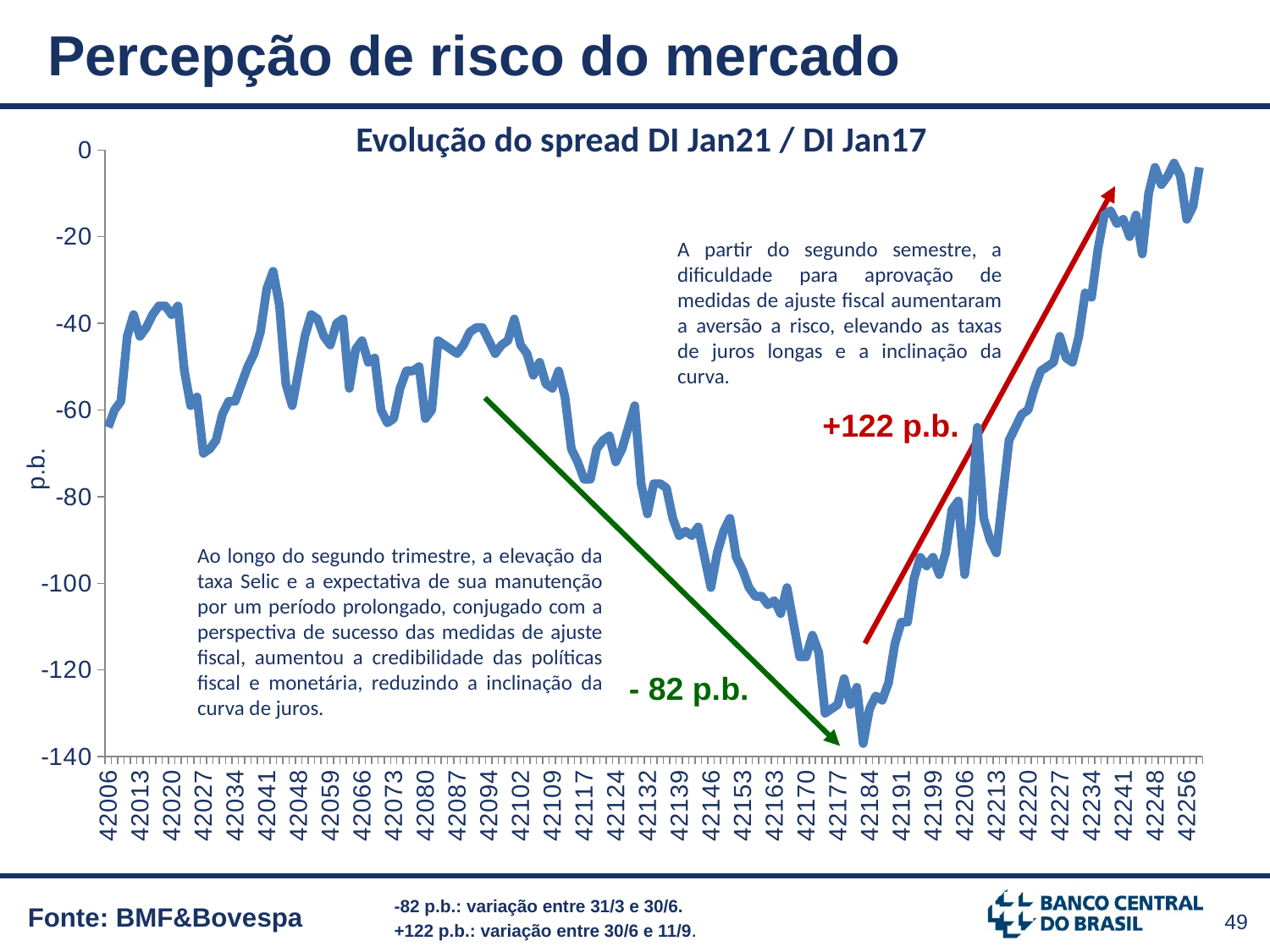
Is the value of the spread at 42041 greater or less than -40? greater What unit is shown on the vertical axis label of the chart? p.b. What change in the spread is indicated by the green arrow annotation? - 82 p.b. What change in the spread is indicated by the red arrow annotation? +122 p.b. Is the value of the spread at 42184 greater or less than -120? less Does the spread rise or fall between 42184 and 42256? rise What is the title of the chart? Evolução do spread DI Jan21 / DI Jan17 What kind of chart is shown on the slide? line chart Which is larger, the spread at 42184 or the spread at 42256? 42256 Does the spread rise or fall between 42094 and 42177? fall